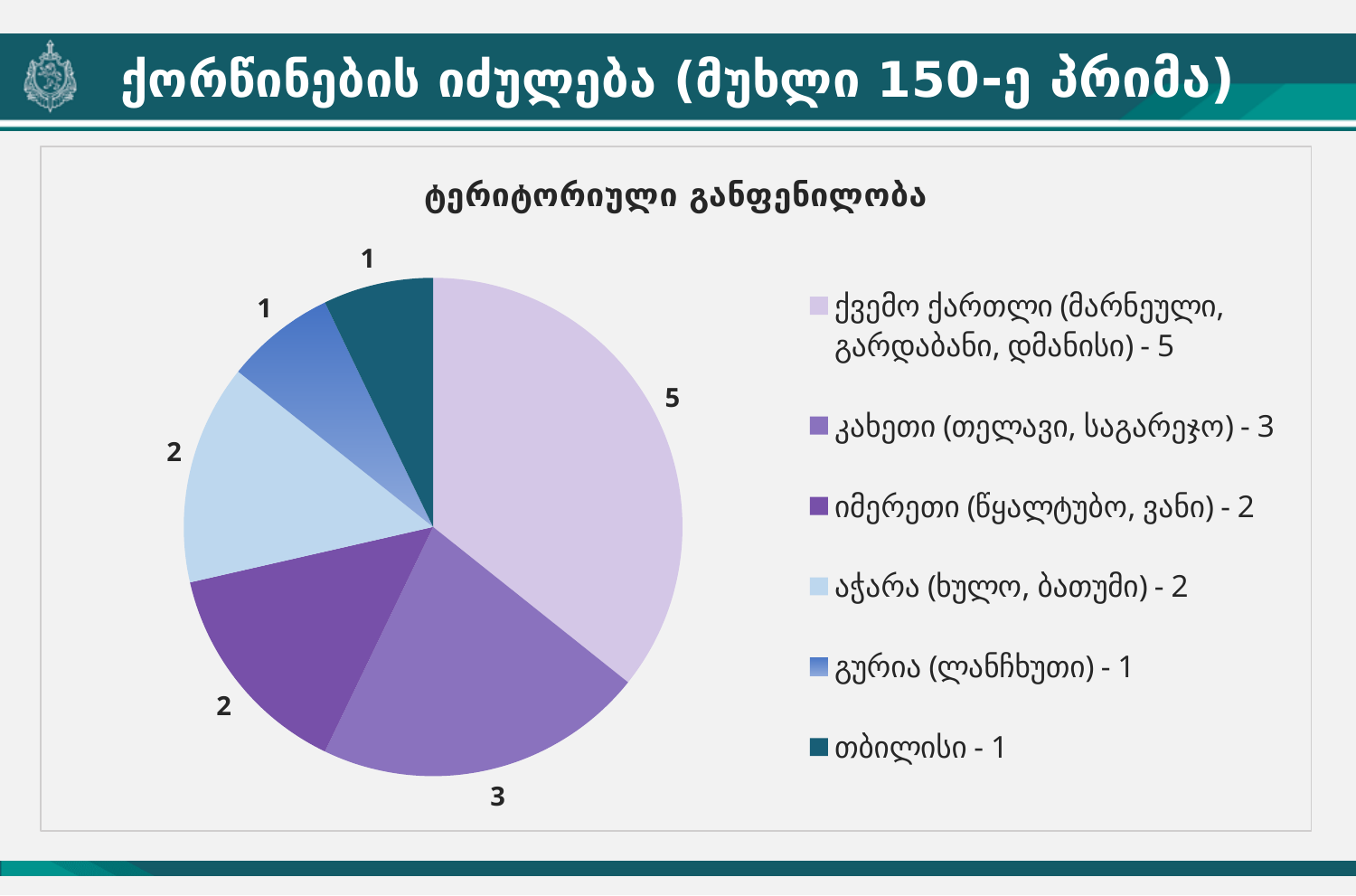
What is the value for კახეთი (თელავი, საგარეჯო)? 3 How many slices does the pie chart have? 6 What is the total of all the slices in the pie chart? 14 What is the value for აჭარა (ხულო, ბათუმი)? 2 Which colour represents თბილისი in the legend? dark teal Which is larger, the value for იმერეთი (წყალტუბო, ვანი) or the value for გურია (ლანჩხუთი)? იმერეთი (წყალტუბო, ვანი) What is the difference between the values for ქვემო ქართლი and კახეთი? 2 What is the value for ქვემო ქართლი (მარნეული, გარდაბანი, დმანისი)? 5 What kind of chart is shown on the slide? pie chart Which region has the largest slice of the pie? ქვემო ქართლი (მარნეული, გარდაბანი, დმანისი) What is the title of the chart? ტერიტორიული განფენილობა What is the value for თბილისი? 1